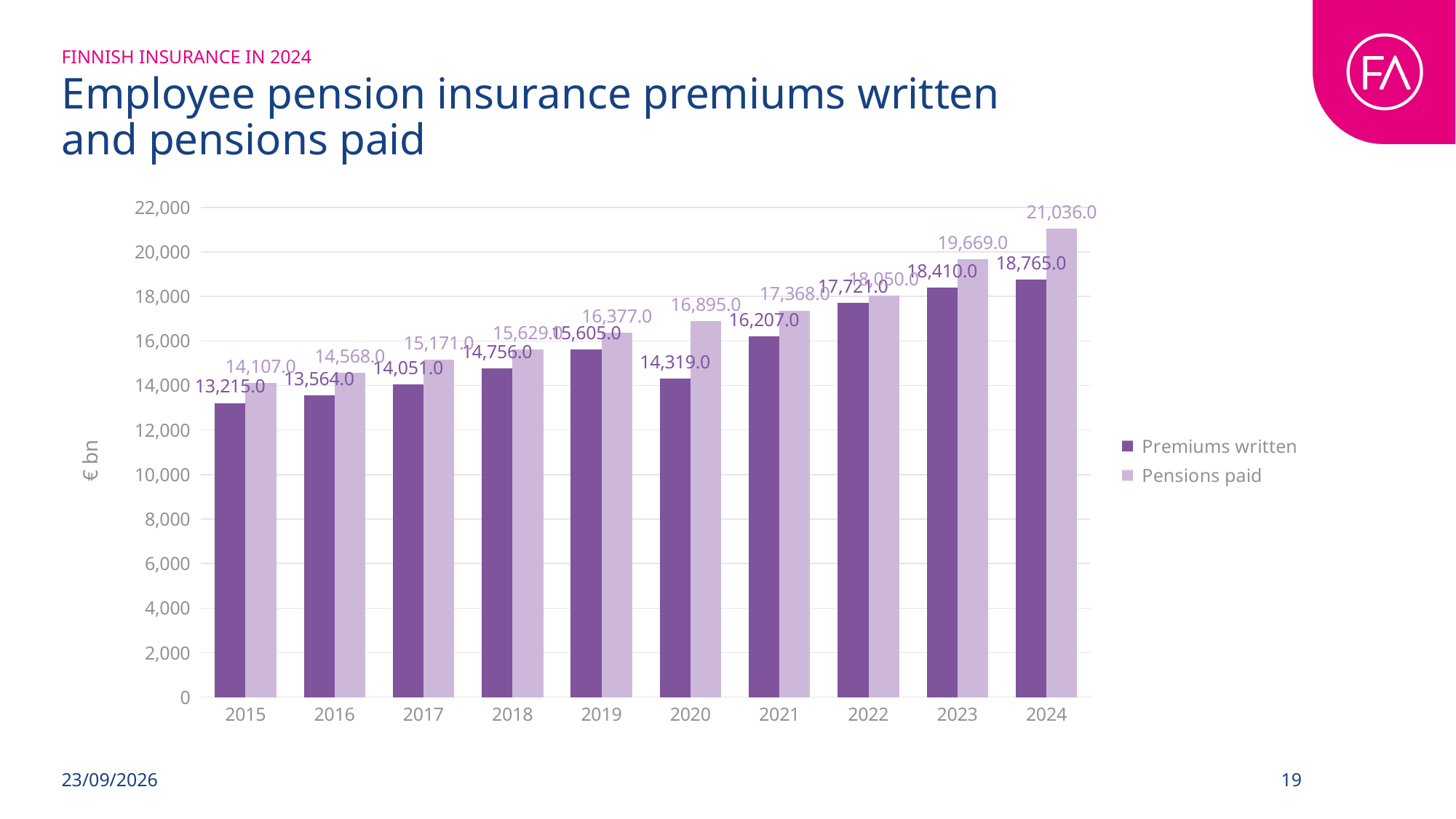
How many years are shown on the x axis? 10 In which year is Pensions paid highest? 2024 What is the difference between Pensions paid and Premiums written in 2024? 2,271.0 Is the value for Pensions paid in 2023 greater or less than 20,000? less In which year is Premiums written lowest? 2015 What is the value for Pensions paid in 2020? 16,895.0 What kind of chart is shown on the slide? Bar chart What is the value for Premiums written in 2020? 14,319.0 In 2020, which is larger: Premiums written or Pensions paid? Pensions paid What is the value for Premiums written in 2024? 18,765.0 By how much did Premiums written increase from 2015 to 2024? 5,550.0 How many series does the legend list? 2